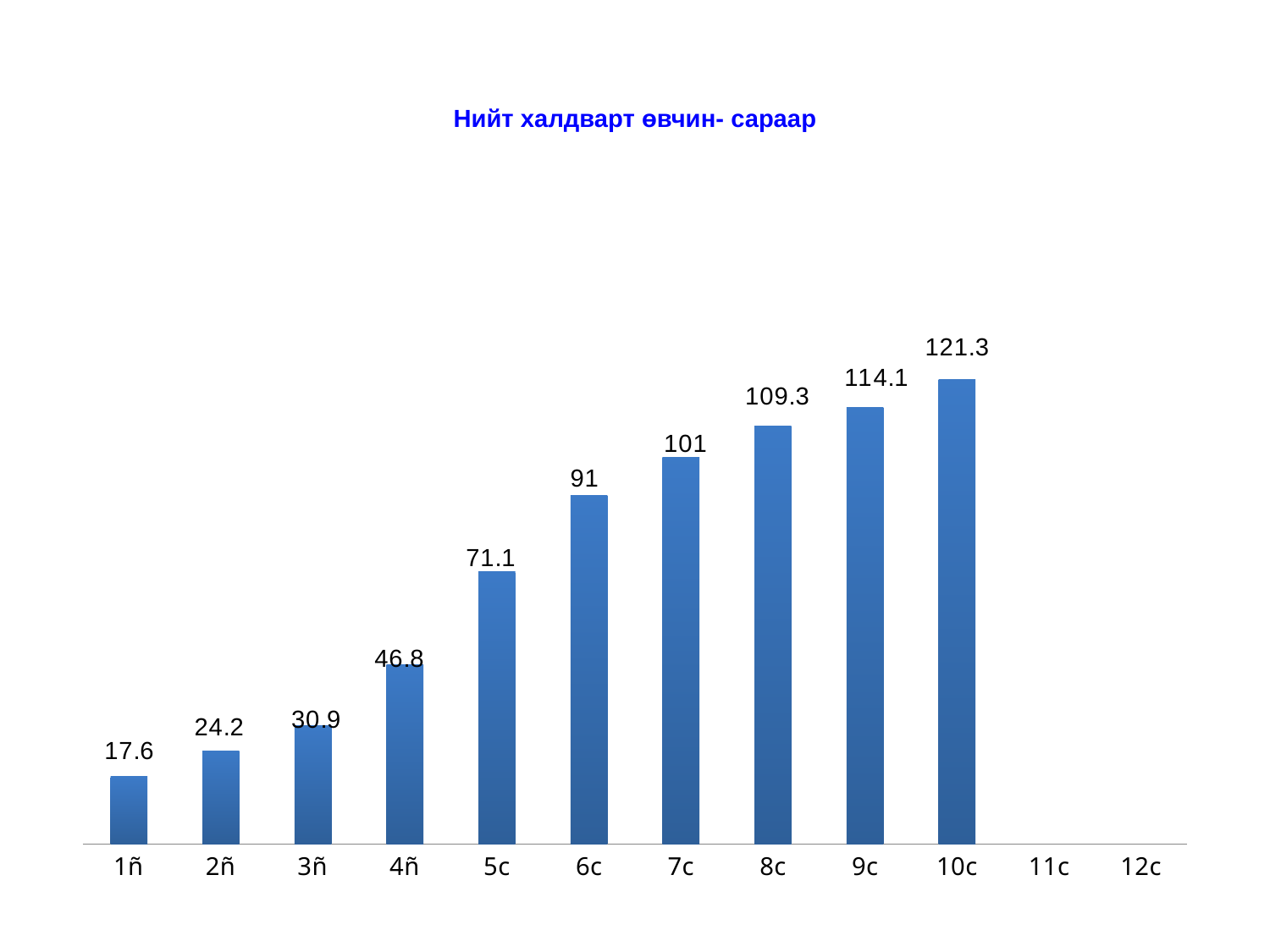
What kind of chart is shown? bar chart What is the value for 10с? 121.3 How many bars are plotted on the chart? 10 Do the values rise or fall from 1ñ to 10с? rise What is the difference between the values for 6с and 4ñ? 44.2 What is the value for 5с? 71.1 What is the value for 8с? 109.3 Which is larger, the value for 7с or the value for 6с? 7с Which category has the lowest plotted value? 1ñ What is the difference between the values for 10с and 9с? 7.2 What is the value for 1ñ? 17.6 Which category has the highest value? 10с